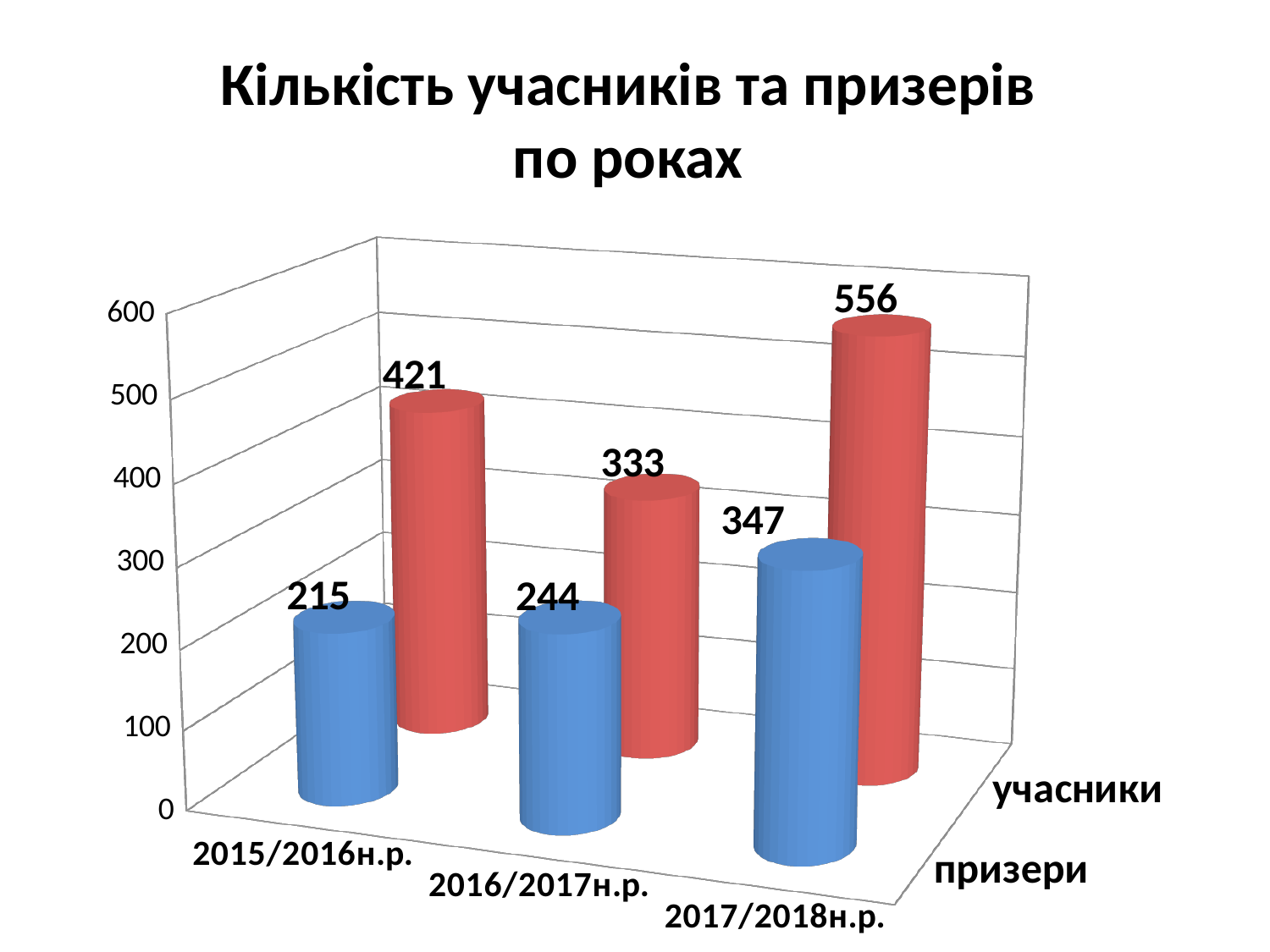
What is the value for учасники in 2015/2016н.р.? 421 What is the difference between учасники and призери in 2017/2018н.р.? 209 What is the value for учасники in 2016/2017н.р.? 333 What kind of chart is shown on the slide? bar chart What is the value for призери in 2015/2016н.р.? 215 Which year has the lowest value for призери? 2015/2016н.р. How many data series does the chart show? 2 Which is larger: учасники in 2016/2017н.р. or призери in 2017/2018н.р.? призери in 2017/2018н.р. What is the value for призери in 2017/2018н.р.? 347 Which year has the highest value for учасники? 2017/2018н.р. Do the values for призери rise or fall from 2015/2016н.р. to 2017/2018н.р.? rise How many years (categories) are shown on the chart? 3